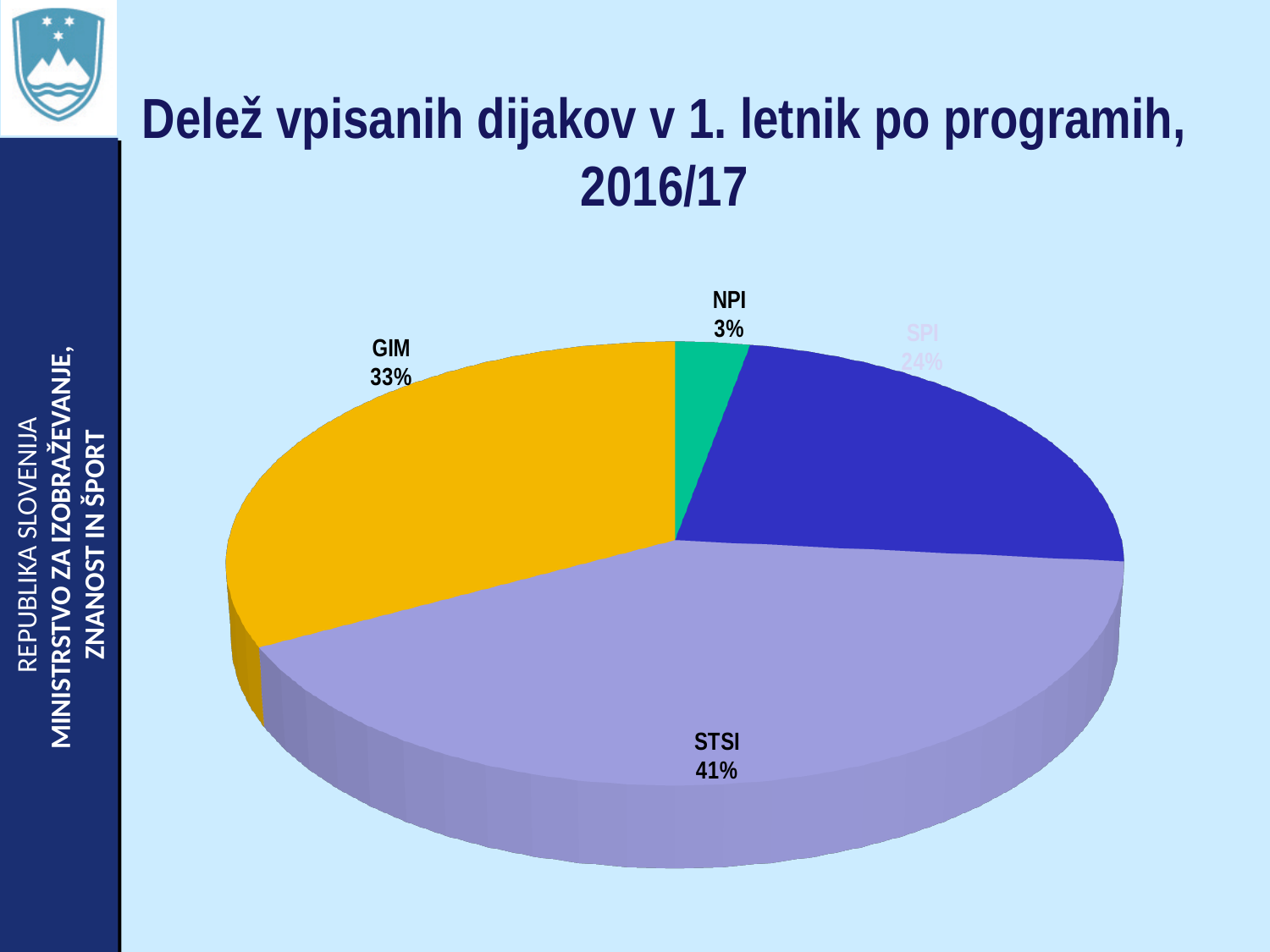
What is the title of the chart? Delež vpisanih dijakov v 1. letnik po programih, 2016/17 How many programmes (slices) are shown in the pie chart? 4 Which programme has the smallest share of enrolled students? NPI What share of the pie does GIM have? 33% What share of the pie does NPI have? 3% What is the difference in percentage points between the STSI and GIM shares? 8 Which programme has the largest share of enrolled students? STSI What type of chart is shown on the slide? Pie chart What is the difference in percentage points between the SPI and NPI shares? 21 What share of the pie does SPI have? 24% Which has a larger share, GIM or SPI? GIM